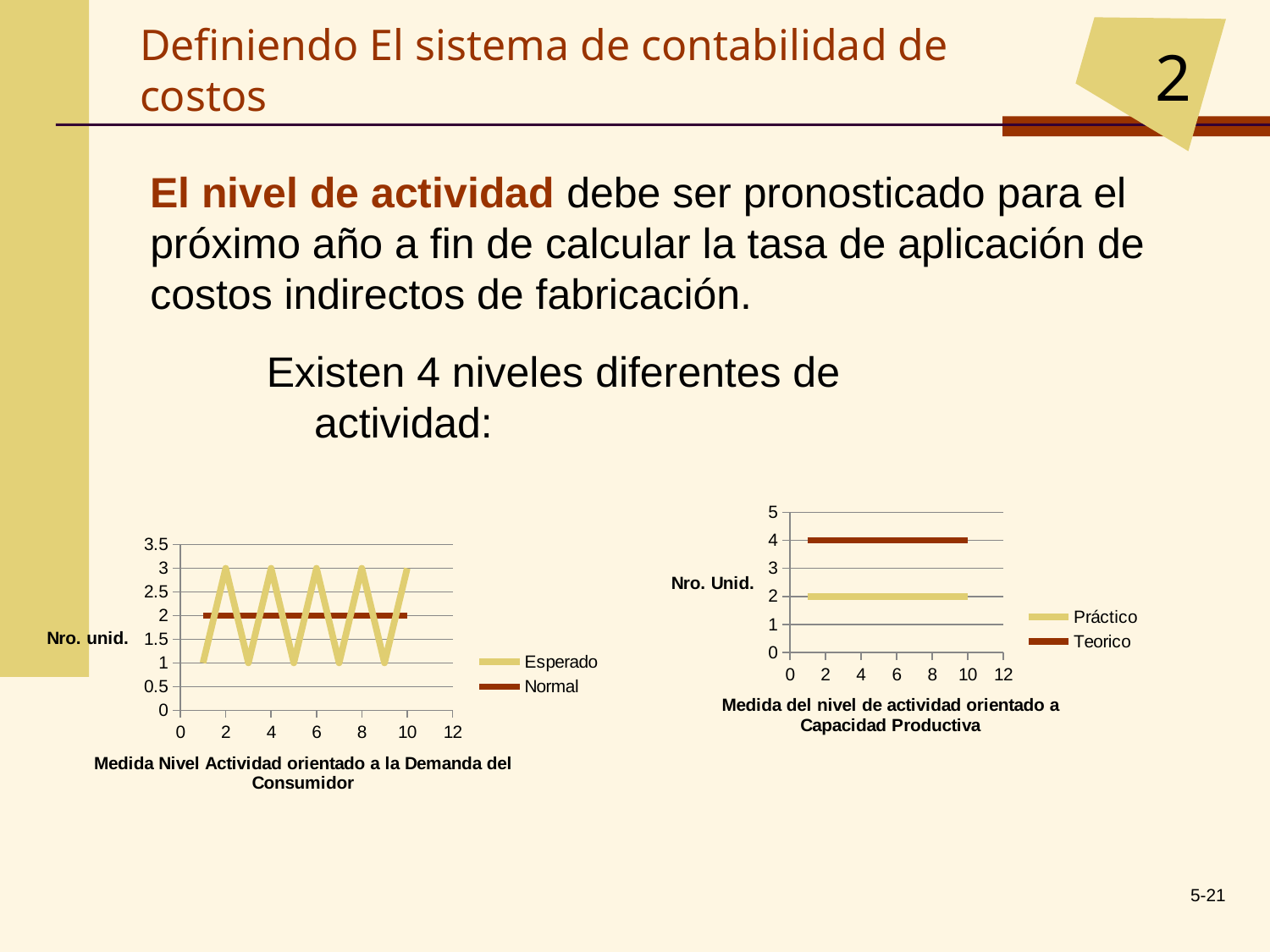
In the chart titled "Medida Nivel Actividad orientado a la Demanda del Consumidor", what is the highest value reached by the Esperado series? 3 In the chart titled "Medida del nivel de actividad orientado a Capacidad Productiva", what constant value does the Práctico series take? 2 In the chart titled "Medida Nivel Actividad orientado a la Demanda del Consumidor", what is the label on the vertical axis? Nro. unid. In the chart titled "Medida Nivel Actividad orientado a la Demanda del Consumidor", how many series does the legend list? 2 In the chart titled "Medida del nivel de actividad orientado a Capacidad Productiva", what constant value does the Teorico series take? 4 In the chart titled "Medida del nivel de actividad orientado a Capacidad Productiva", does the Teorico series rise, fall, or stay flat along the x axis? Stays flat In the chart titled "Medida Nivel Actividad orientado a la Demanda del Consumidor", what is the lowest value reached by the Esperado series? 1 In the chart titled "Medida Nivel Actividad orientado a la Demanda del Consumidor", what constant value does the Normal series take? 2 In the chart titled "Medida del nivel de actividad orientado a Capacidad Productiva", how many series does the legend list? 2 In the chart titled "Medida del nivel de actividad orientado a Capacidad Productiva", what is the difference between the Teorico value and the Práctico value? 2 In the chart titled "Medida Nivel Actividad orientado a la Demanda del Consumidor", what type of chart is shown? Line chart In the chart titled "Medida del nivel de actividad orientado a Capacidad Productiva", which series has the higher value, Práctico or Teorico? Teorico